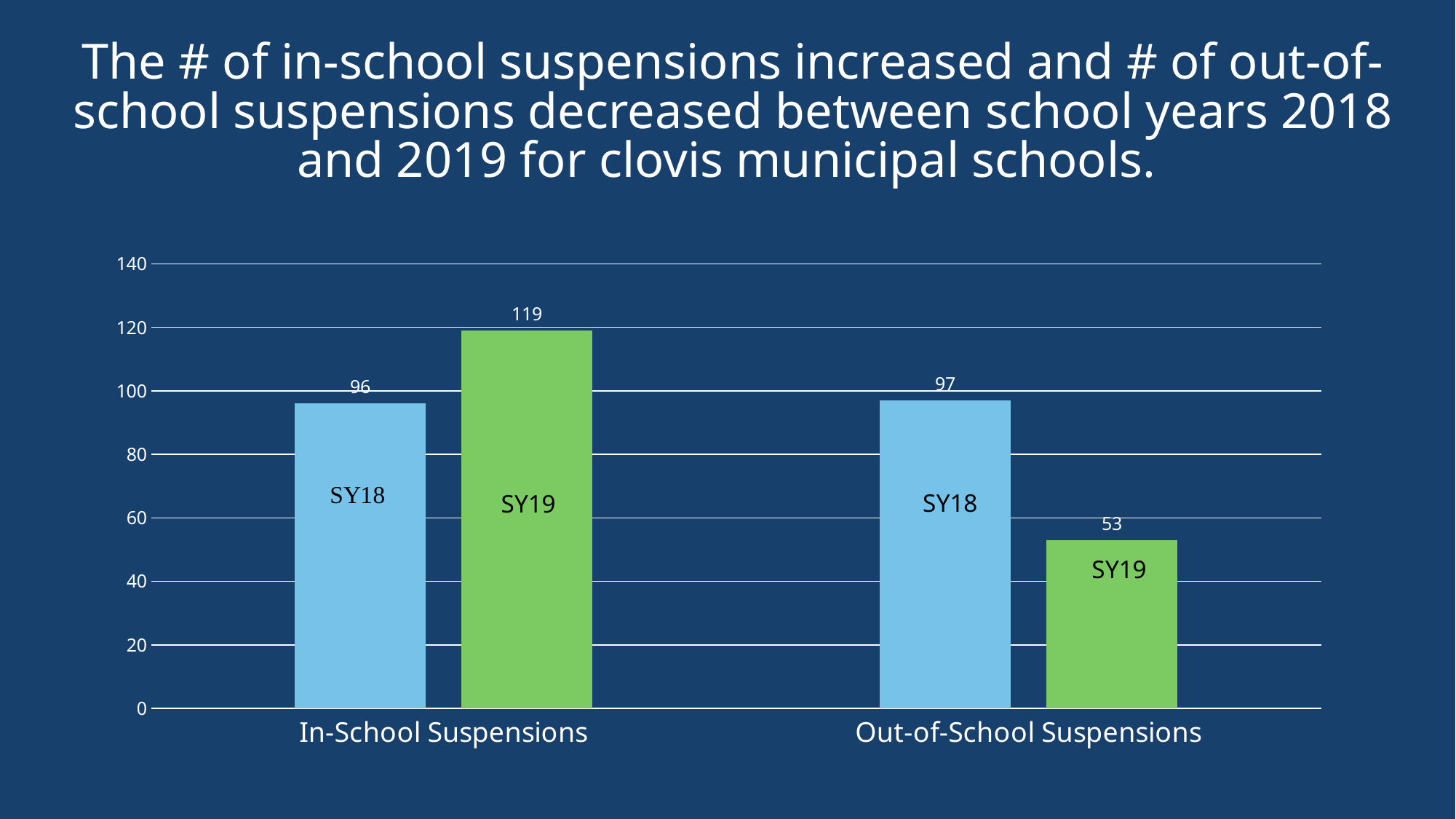
What is the value for SY18 In-School Suspensions? 96 By how much did Out-of-School Suspensions decrease from SY18 to SY19? 44 Which is larger: SY19 In-School Suspensions or SY19 Out-of-School Suspensions? SY19 In-School Suspensions Which bar has the lowest value on the chart? SY19 Out-of-School Suspensions Which bar has the highest value on the chart? SY19 In-School Suspensions By how much did In-School Suspensions increase from SY18 to SY19? 23 What is the value for SY19 In-School Suspensions? 119 What kind of chart is shown on the slide? Bar chart What colour are the SY19 bars? Green How many categories are shown on the x axis? 2 What is the value for SY18 Out-of-School Suspensions? 97 What is the value for SY19 Out-of-School Suspensions? 53